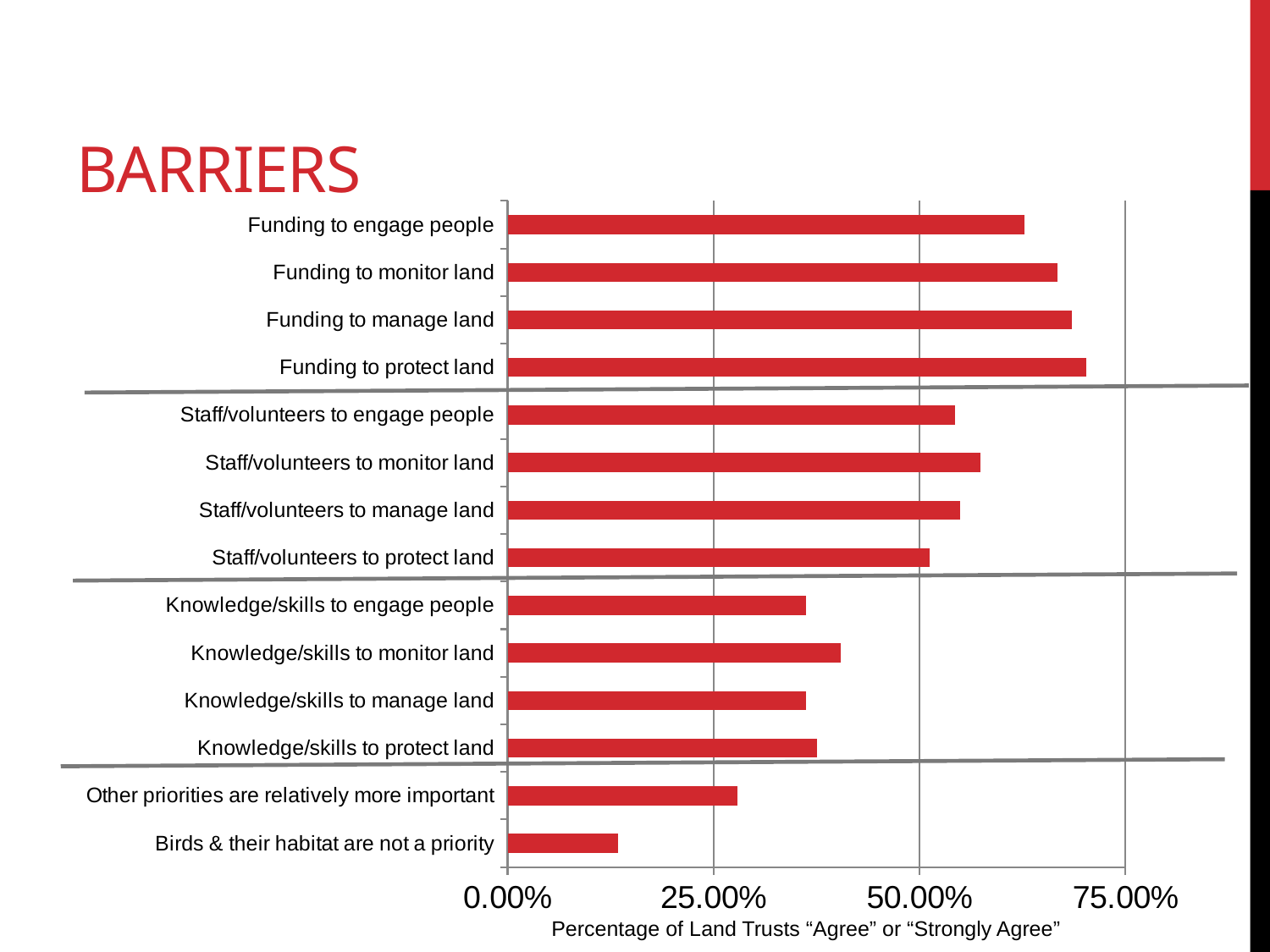
Is the value for "Knowledge/skills to monitor land" greater or less than 50.00%? less Is the value for "Funding to engage people" greater or less than 75.00%? less Which is larger: the value for "Knowledge/skills to engage people" or the value for "Other priorities are relatively more important"? Knowledge/skills to engage people What is the title of the horizontal axis of the chart? Percentage of Land Trusts "Agree" or "Strongly Agree" What kind of chart is shown on the slide? Bar chart Which is larger: the value for "Funding to monitor land" or the value for "Staff/volunteers to monitor land"? Funding to monitor land Is the value for "Funding to protect land" greater or less than 50.00%? greater How many categories (bars) are plotted in the chart? 14 Which barrier has the lowest percentage of land trusts agreeing or strongly agreeing? Birds & their habitat are not a priority Which barrier has the highest percentage of land trusts agreeing or strongly agreeing? Funding to protect land